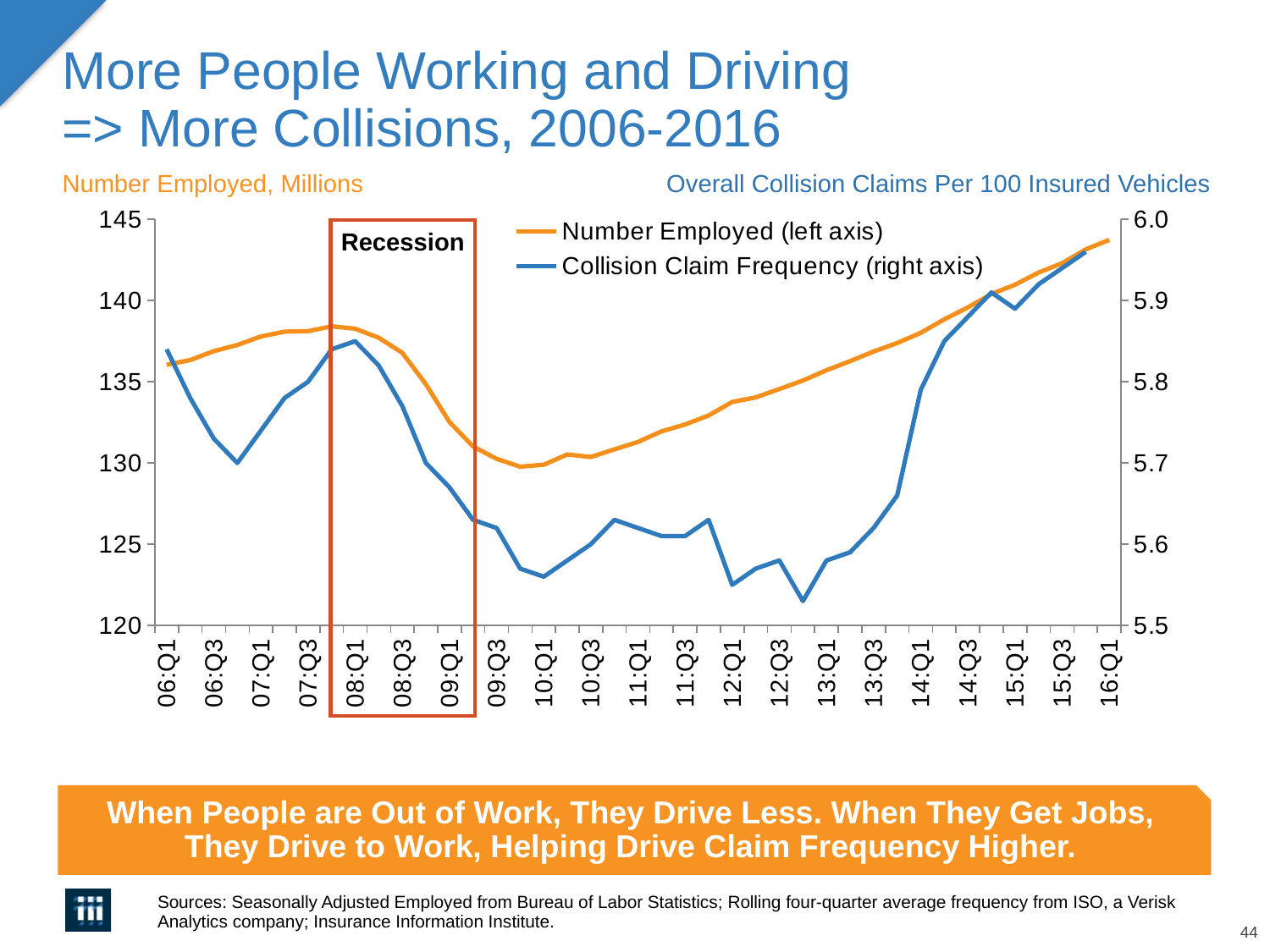
What is the title of the left axis? Number Employed, Millions Is the value for Number Employed at 10:Q1 greater or less than 135? less Is the value for Collision Claim Frequency at 08:Q1 greater or less than 5.8? greater Which series is plotted against the right axis? Collision Claim Frequency At which quarter is Number Employed highest? 16:Q1 What kind of chart is shown on the slide? Line chart Is the value for Number Employed at 16:Q1 greater or less than 140? greater How many series does the legend list? 2 Does Number Employed rise or fall from 10:Q1 to 16:Q1? Rise Is Number Employed higher at 16:Q1 or at 08:Q1? 16:Q1